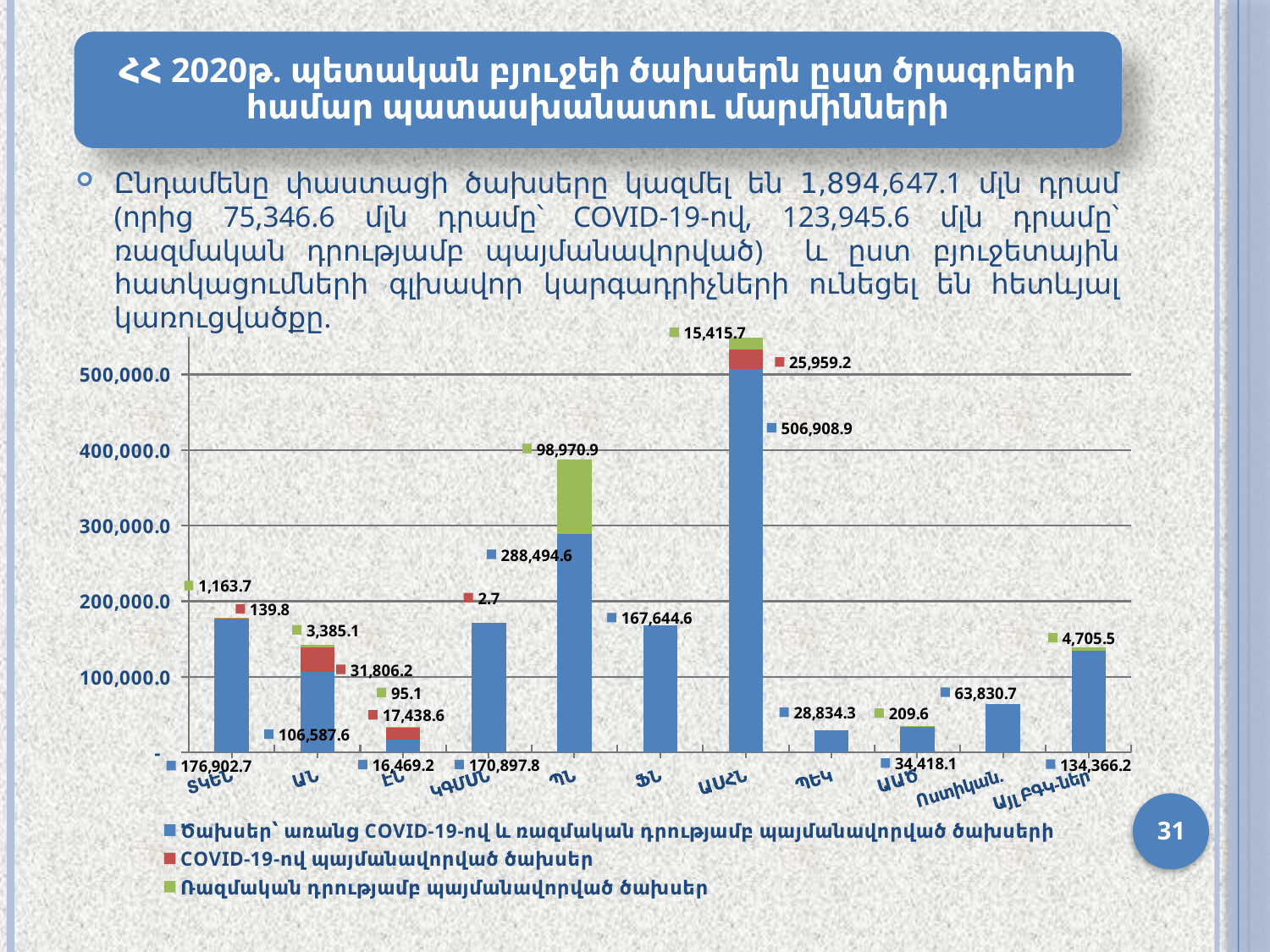
Is the total bar for ՊԵԿ greater or less than 100,000.0? less What type of chart is shown on the slide? Stacked bar chart What is the value of the blue series (expenses without COVID-19 and martial law) for ԱՍՀՆ? 506,908.9 What is the value of the red series (COVID-19-related expenses) for ԱՆ? 31,806.2 What is the total of the stacked bar for ՊՆ? 387,465.5 Which category has the lowest value in the blue series? ԷՆ Which category has the highest value in the blue series? ԱՍՀՆ What is the difference between the blue series values for ԱՍՀՆ and ՊՆ? 218,414.3 Which is larger, the blue series value for ՏԿԵՆ or for ՖՆ? ՏԿԵՆ What is the value of the green series (martial-law-related expenses) for ՊՆ? 98,970.9 How many series does the chart legend list? 3 How many categories are shown along the x axis of the chart? 11